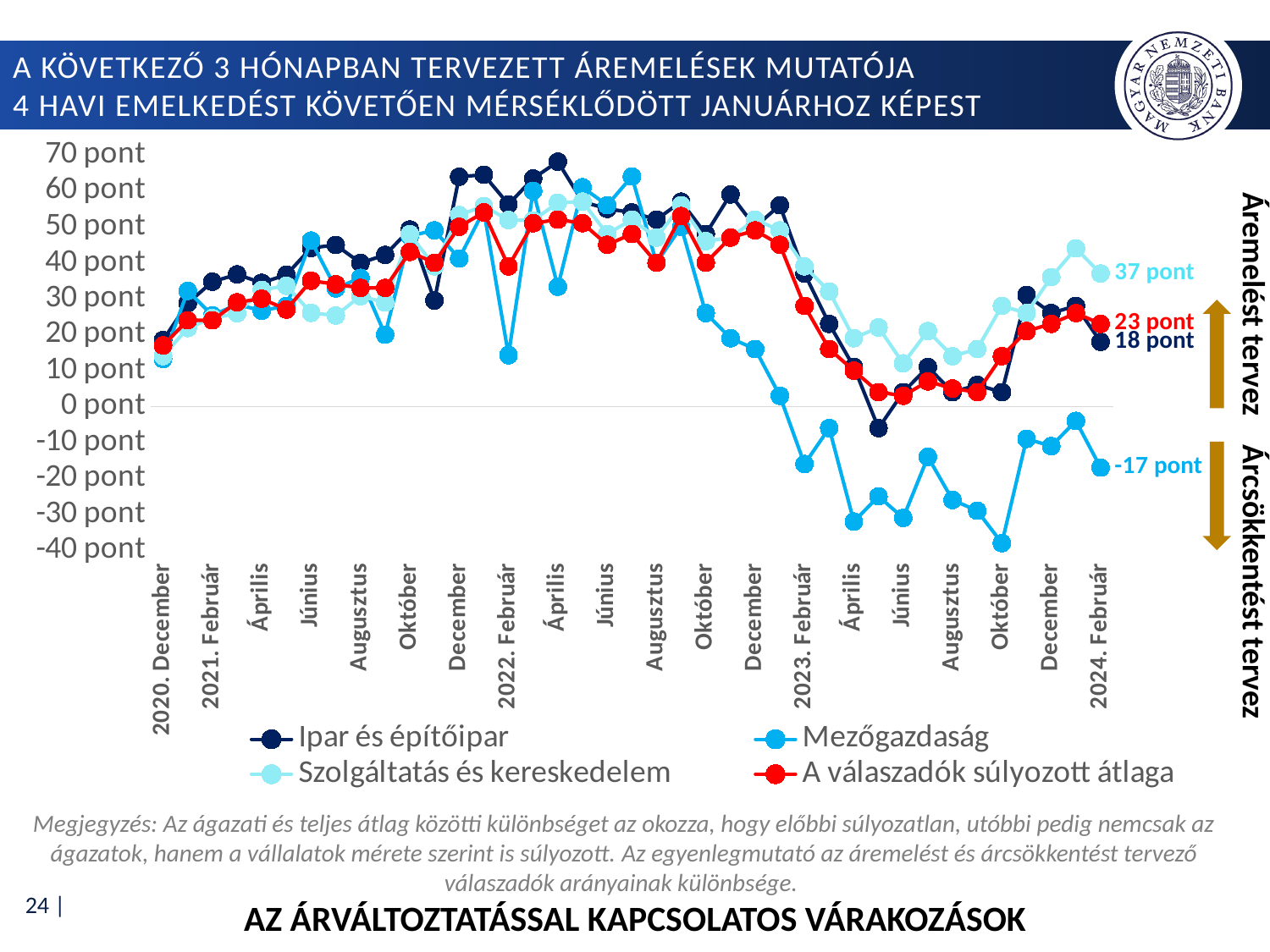
Which series has the lowest value in 2024. Február? Mezőgazdaság What is the value for Szolgáltatás és kereskedelem in 2024. Február? 37 pont What is the value for Mezőgazdaság in 2024. Február? -17 pont How many series does the legend list? 4 What is the value for Ipar és építőipar in 2024. Február? 18 pont Does the Mezőgazdaság series rise or fall between 2022. Október and 2023. Április? fall Is the value for Mezőgazdaság in 2023. Október greater or less than -30 pont? less What kind of chart is shown on the slide? line chart In 2024. Február, which is larger: Ipar és építőipar or A válaszadók súlyozott átlaga? A válaszadók súlyozott átlaga Which series has the highest value in 2024. Február? Szolgáltatás és kereskedelem What is the value for A válaszadók súlyozott átlaga in 2024. Február? 23 pont What is the difference between Szolgáltatás és kereskedelem and Mezőgazdaság in 2024. Február? 54 pont